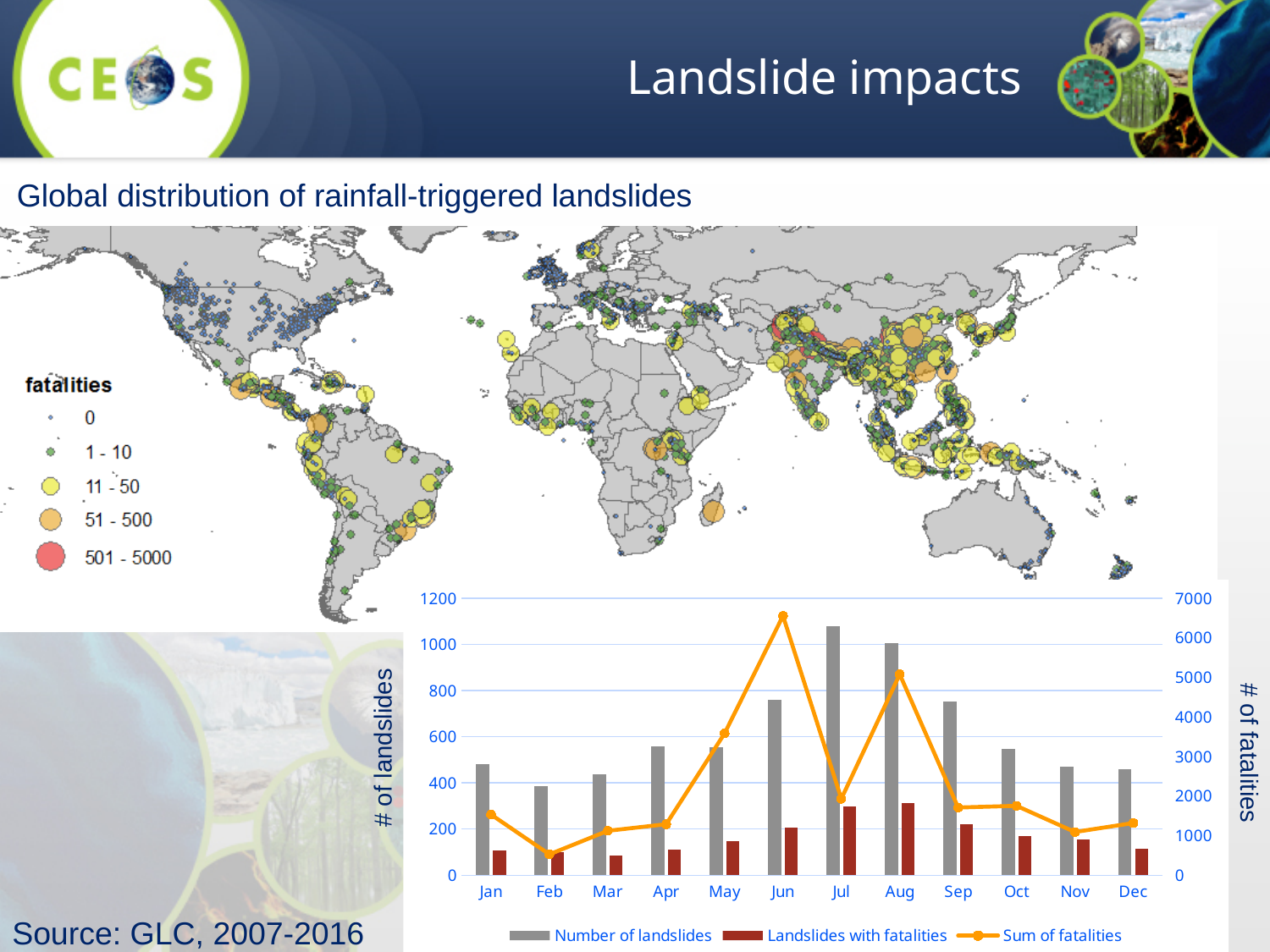
Which month has a larger Number of landslides, Jun or Oct? Jun What kind of chart is shown at the bottom right of the slide? A combined bar and line chart In which month is the Sum of fatalities highest? Jun In which month is the Number of landslides lowest? Feb How many series does the chart legend list? 3 In which month is the Number of landslides highest? Jul How many months are shown on the x axis of the chart? 12 Does the Number of landslides rise or fall from Aug to Dec? fall Is the Number of landslides in Jul greater or less than 1000? greater What is the label on the right-hand vertical axis of the chart? # of fatalities Is the Sum of fatalities in Jun greater or less than 6000? greater